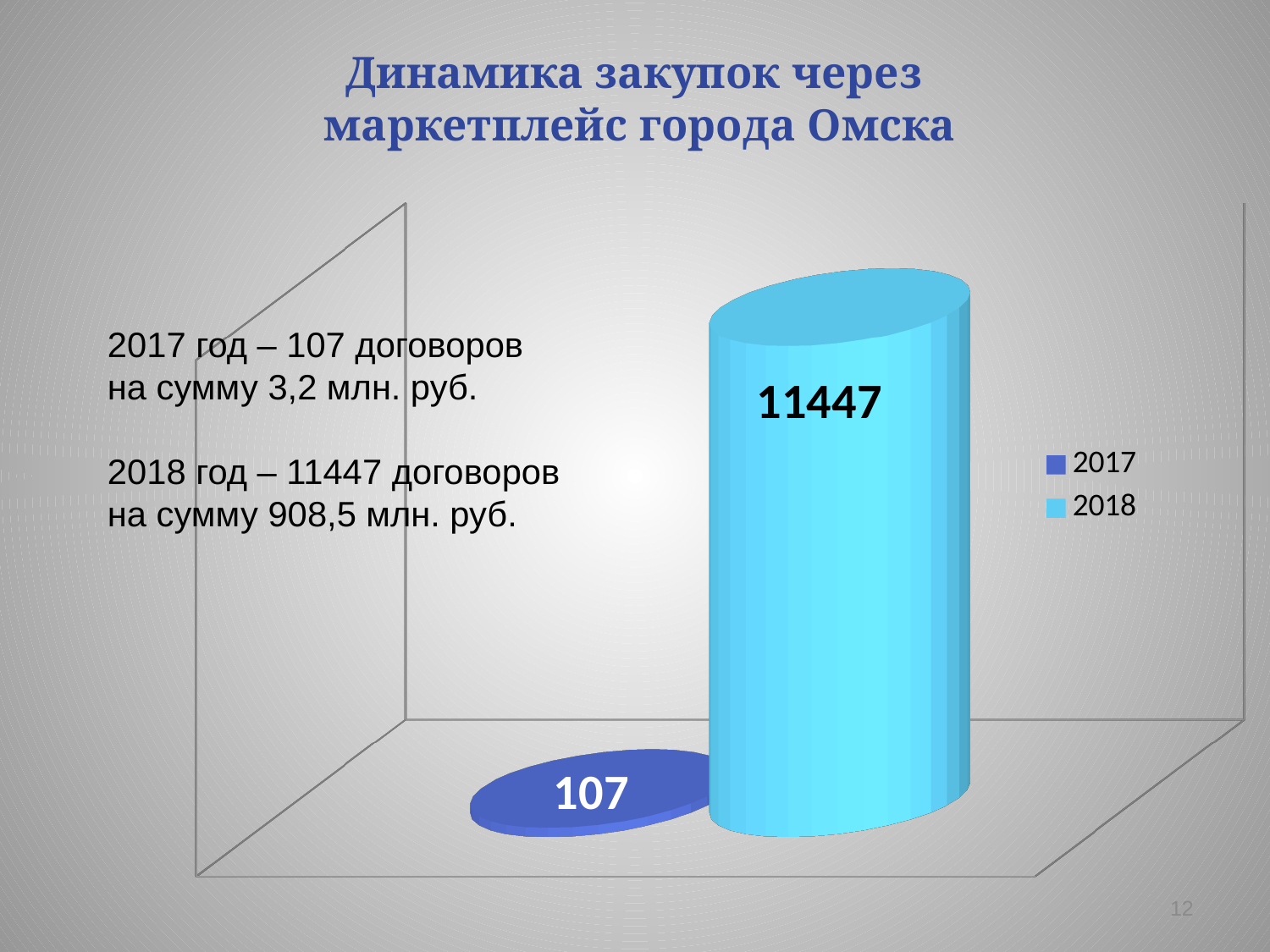
What value is shown for 2017 on the chart? 107 What value is shown for 2018 on the chart? 11447 Which is larger, the value for 2017 or the value for 2018? 2018 Which year has the highest value on the chart? 2018 What is the title of the slide containing the chart? Динамика закупок через маркетплейс города Омска Do the values rise or fall from 2017 to 2018? Rise How many series does the legend list? 2 What kind of chart is shown on the slide? Bar chart What is the difference between the values for 2018 and 2017? 11340 Which legend entry is shown in light blue? 2018 Which year has the lowest value on the chart? 2017 How many bars are plotted on the chart? 2